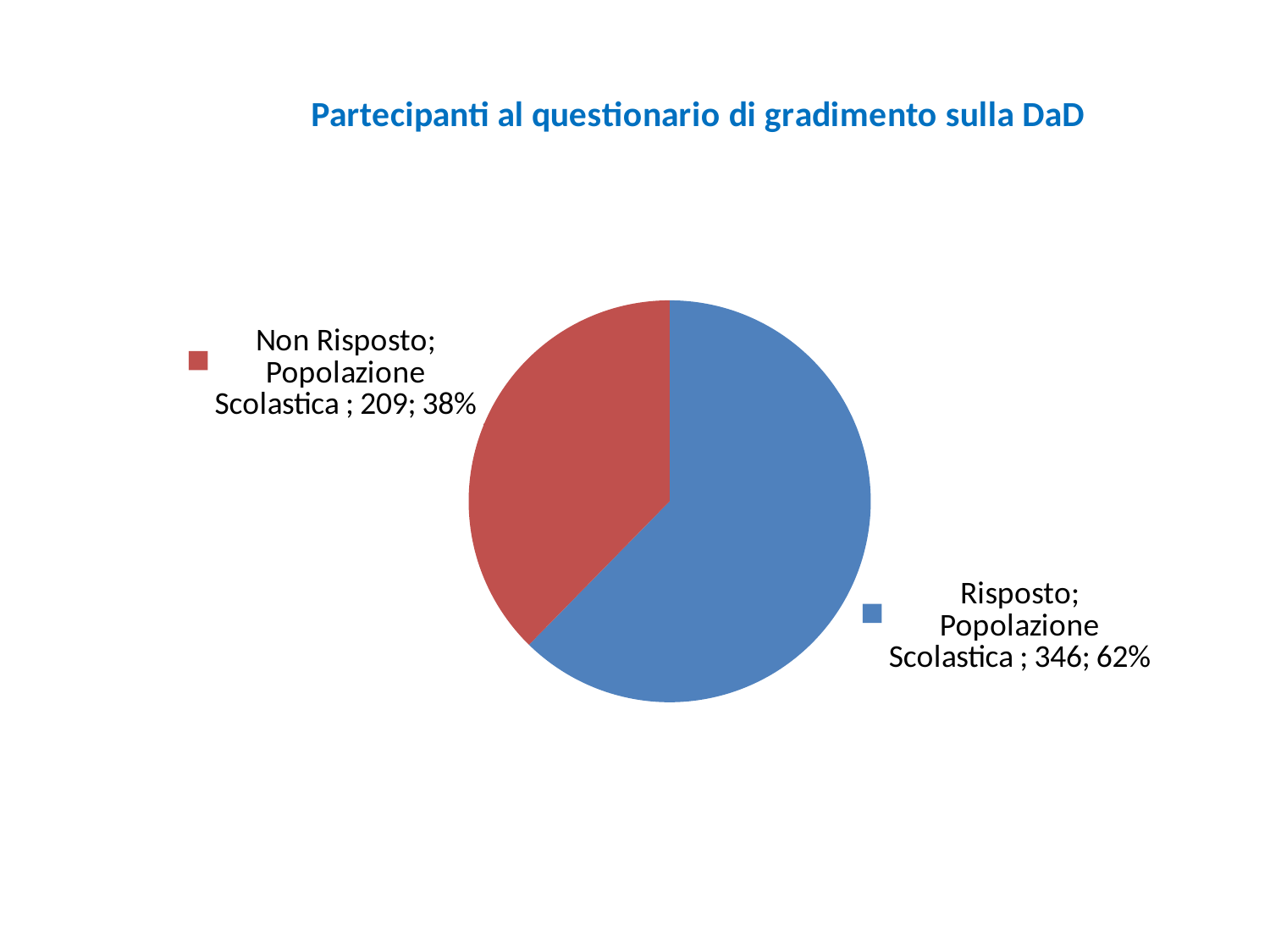
What share of the pie does the Non Risposto slice represent? 38% What is the title of the chart? Partecipanti al questionario di gradimento sulla DaD What share of the pie does the Risposto slice represent? 62% What colour is the Non Risposto slice? red Which slice is the largest? Risposto How many slices does the pie chart have? 2 What is the value for Non Risposto? 209 What is the value for Risposto? 346 What kind of chart is shown on the slide? pie chart Which is larger, Risposto or Non Risposto? Risposto Which slice is the smallest? Non Risposto What is the difference between the Risposto and Non Risposto values? 137